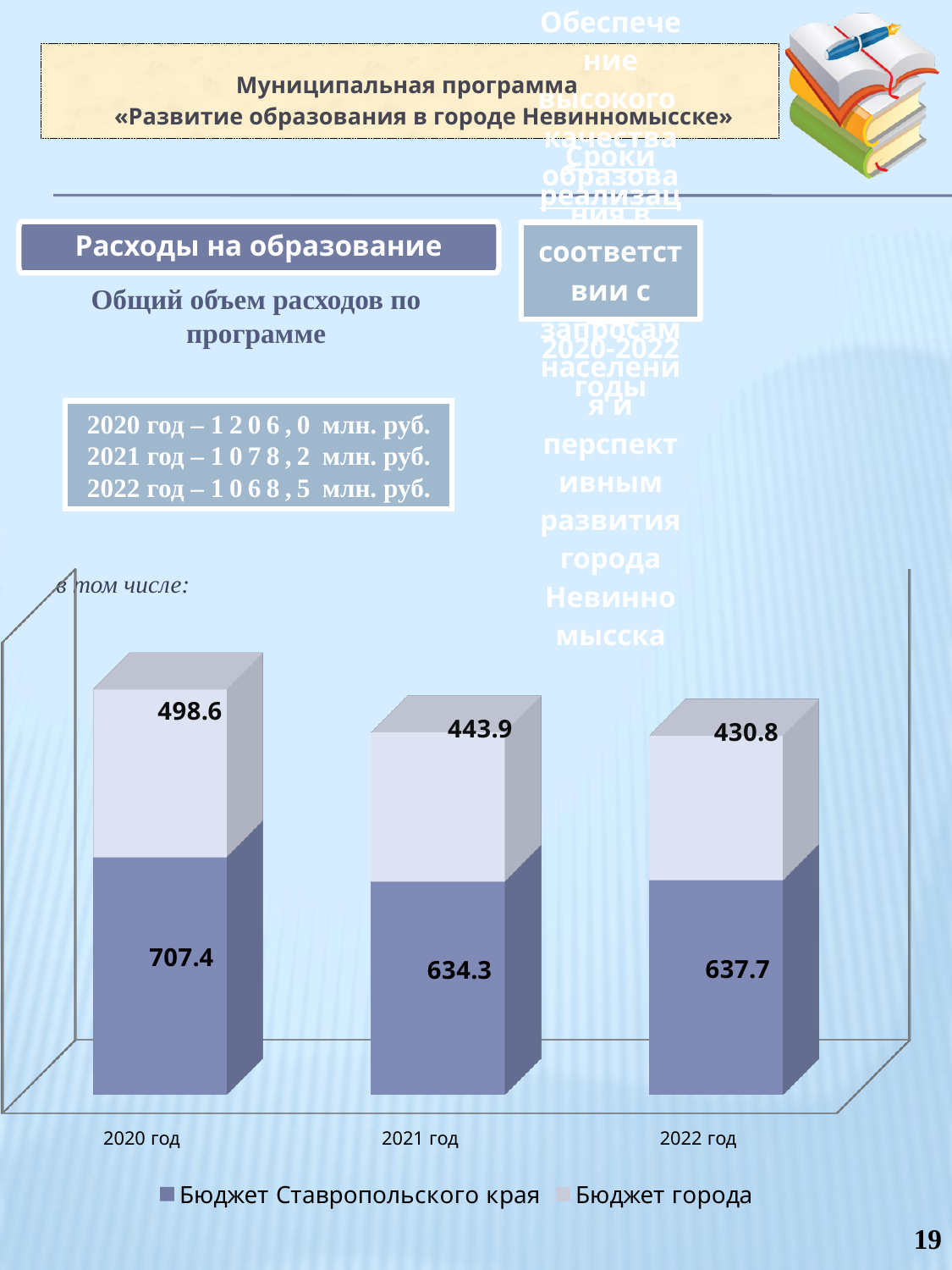
How many years (categories) are shown on the x axis of the chart? 3 What is the total of the stacked bar for 2020 год? 1206.0 What is the value of Бюджет Ставропольского края for 2020 год? 707.4 How does the Бюджет города value change from 2020 год to 2022 год? falls What is the value of Бюджет города for 2022 год? 430.8 What is the difference between the Бюджет Ставропольского края values for 2020 год and 2021 год? 73.1 What type of chart is shown on the slide? stacked bar chart What is the value of Бюджет города for 2021 год? 443.9 Which is larger: Бюджет Ставропольского края for 2021 год or for 2022 год? 2022 год How many series does the chart legend list? 2 In which year is the Бюджет Ставропольского края value the highest? 2020 год In which year is the Бюджет города value the lowest? 2022 год